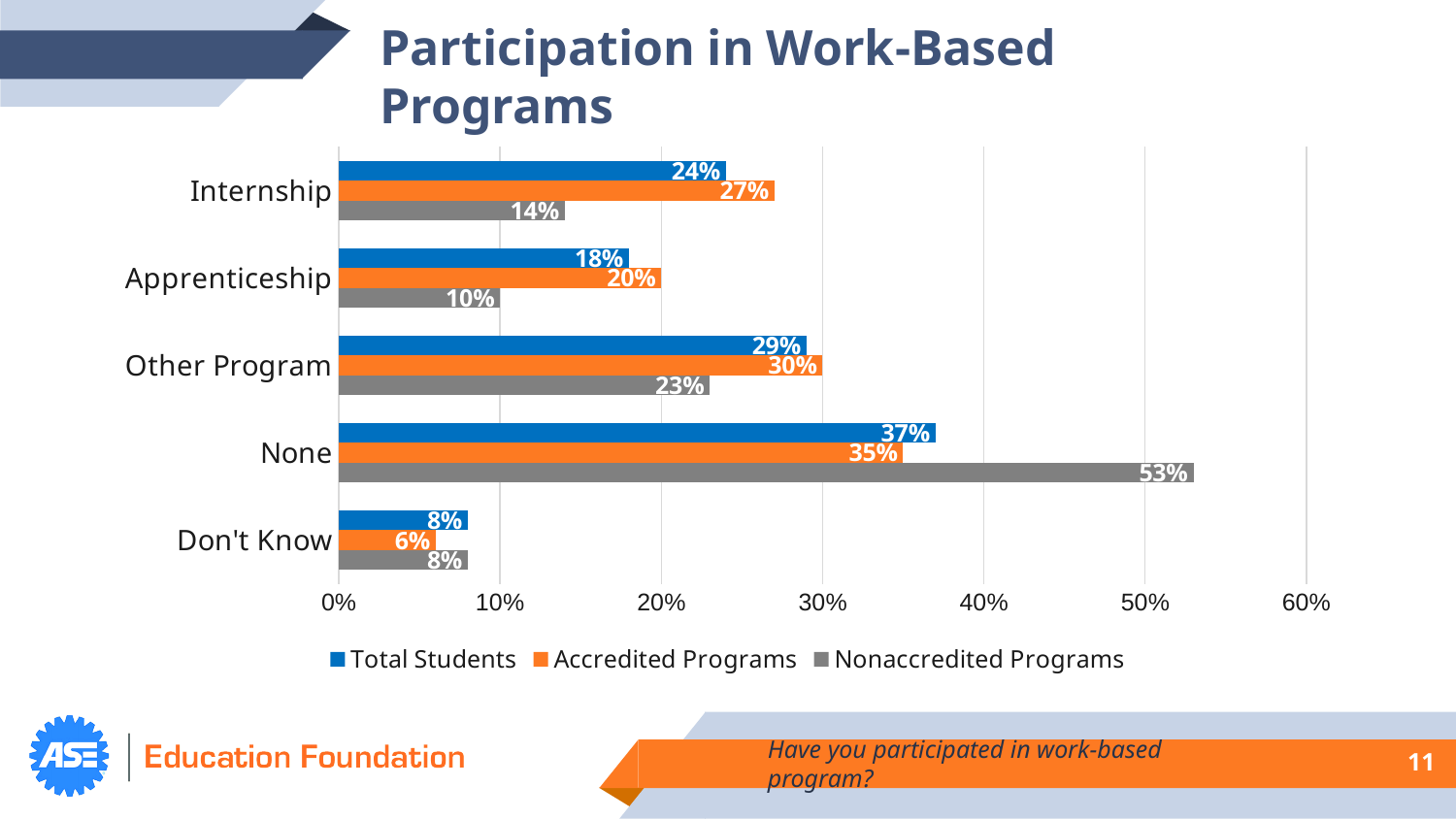
What kind of chart is shown on the slide? Bar chart What is the value for Accredited Programs for Apprenticeship? 20% What is the value for Total Students for Internship? 24% What is the difference between the Nonaccredited Programs and Total Students values for None? 16% Which category has the lowest value for Accredited Programs? Don't Know Is the Total Students value for Other Program greater or less than 20%? greater How many categories are shown on the chart? 5 What is the value for Nonaccredited Programs for None? 53% Which category has the highest value for Nonaccredited Programs? None For Internship, which is larger: Accredited Programs or Nonaccredited Programs? Accredited Programs What is the title of the chart? Participation in Work-Based Programs How many series does the legend list? 3